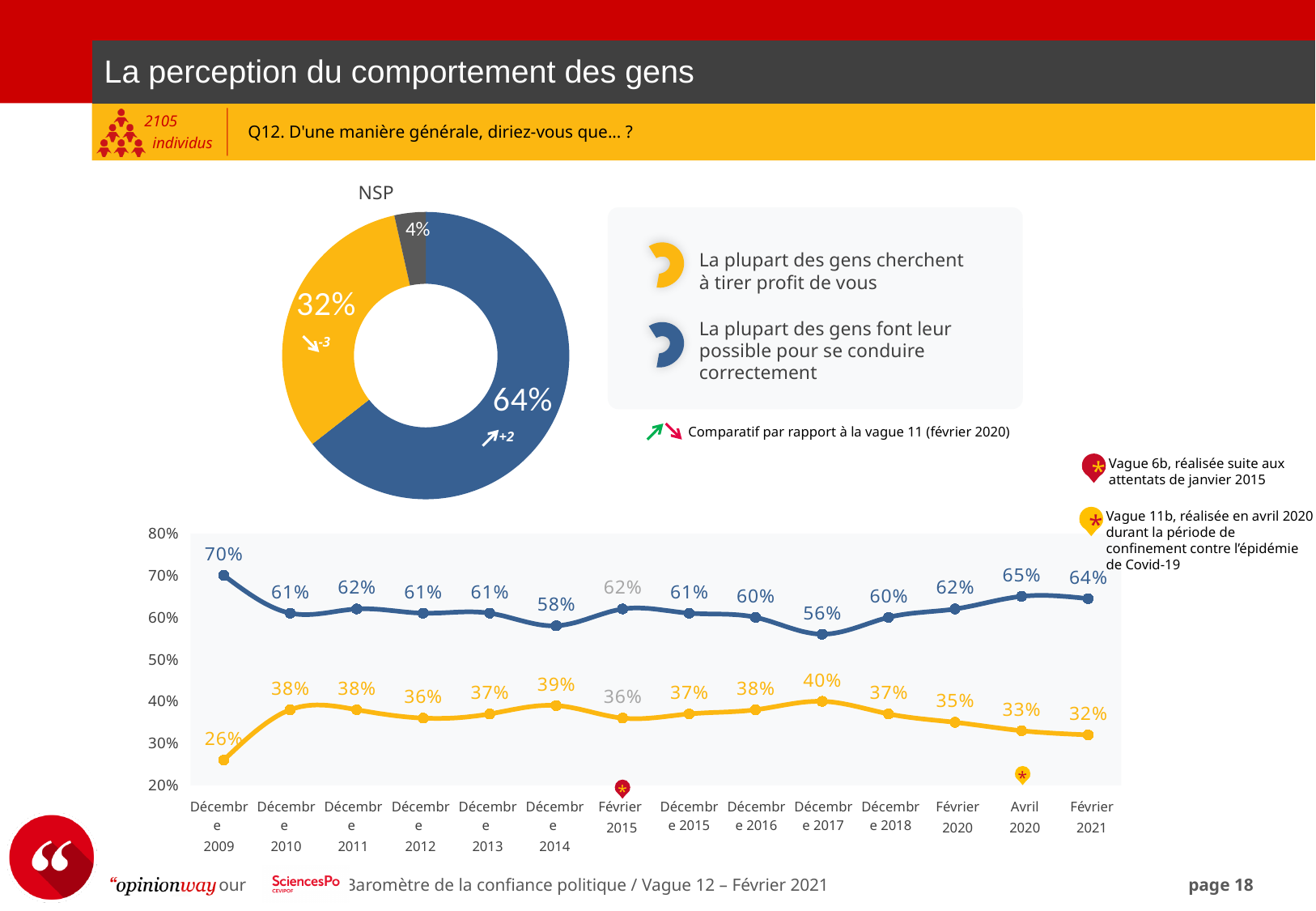
In the line chart, in which period is the yellow series at its lowest? Décembre 2009 In the line chart, what is the value of the blue series in Décembre 2009? 70% In the donut chart, what is the NSP share? 4% In the line chart, how many time points are plotted along the x axis? 14 In the line chart, what is the difference between the blue and yellow series in Février 2021? 32 points In the donut chart, what share of respondents say most people try to take advantage of you? 32% What kind of chart is the chart at the bottom of the slide? Line chart In the line chart, what is the value of the yellow series in Décembre 2017? 40% In the donut chart, what share of respondents say most people do their best to behave correctly? 64% In the donut chart, what is the difference between the 64% slice and the 32% slice? 32 points In the line chart, in which period is the blue series at its lowest? Décembre 2017 In the line chart, which is larger: the blue series in Avril 2020 or the blue series in Février 2021? Avril 2020